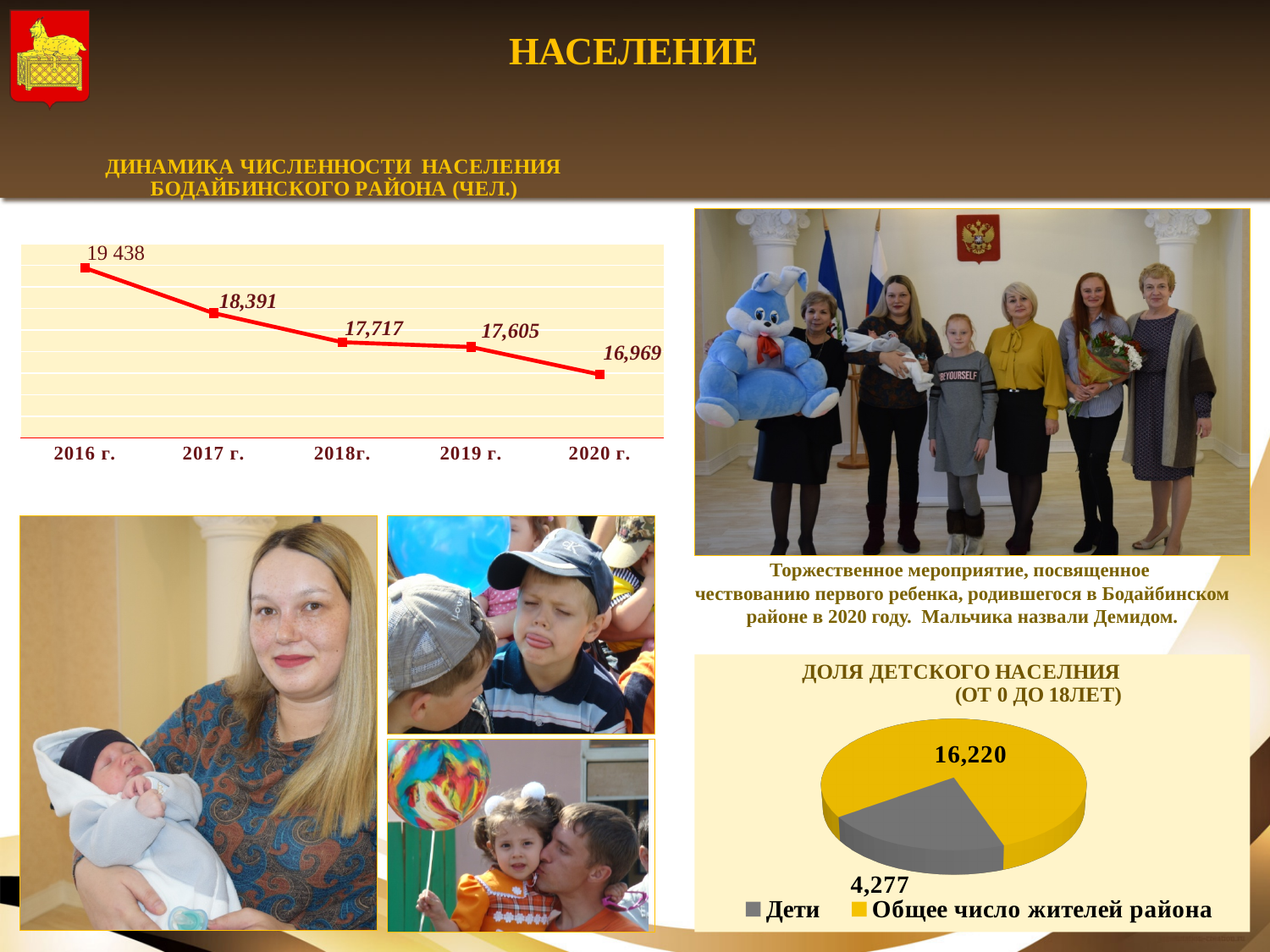
In the pie chart 'Доля детского населения (от 0 до 18 лет)', which slice is larger: 'Дети' or 'Общее число жителей района'? Общее число жителей района In the line chart 'Динамика численности населения Бодайбинского района', what is the value for 2018г.? 17,717 How many years are plotted in the line chart 'Динамика численности населения Бодайбинского района'? 5 In the line chart 'Динамика численности населения Бодайбинского района', what is the difference between the 2019 г. and 2020 г. values? 636 What kind of chart is 'Доля детского населения (от 0 до 18 лет)'? pie chart In the line chart 'Динамика численности населения Бодайбинского района', what is the difference between the 2016 г. and 2017 г. values? 1,047 In the pie chart 'Доля детского населения (от 0 до 18 лет)', what is the value for 'Дети'? 4,277 In the line chart 'Динамика численности населения Бодайбинского района', which year has the highest value? 2016 г. In the line chart 'Динамика численности населения Бодайбинского района', which year has the lowest value? 2020 г. In the line chart 'Динамика численности населения Бодайбинского района', do the values rise or fall from 2016 г. to 2020 г.? fall In the line chart 'Динамика численности населения Бодайбинского района', what is the value for 2020 г.? 16,969 In the line chart 'Динамика численности населения Бодайбинского района', what is the population value for 2016 г.? 19 438